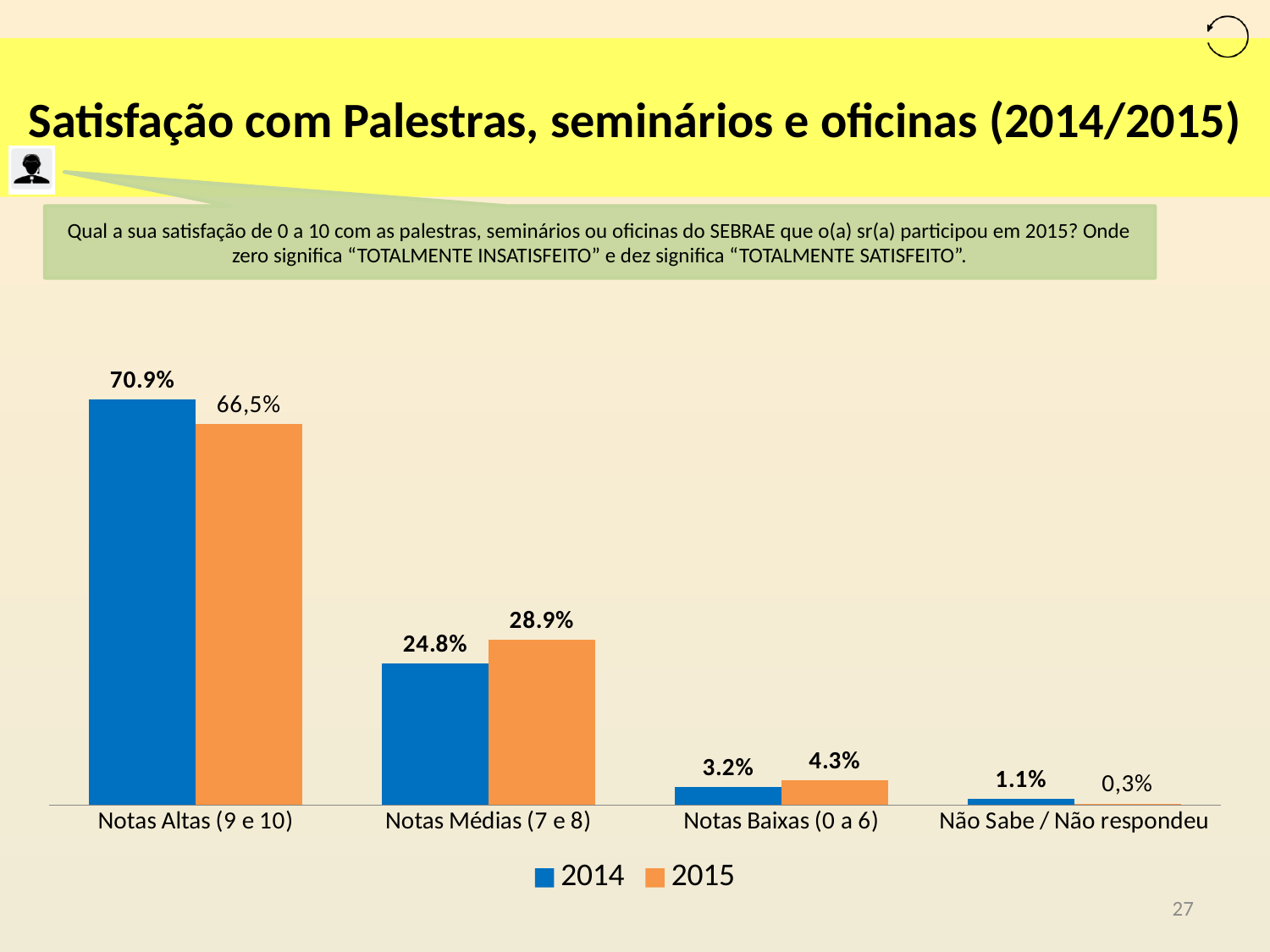
What kind of chart is shown on the slide? Bar chart What is the value for 2014 in the Notas Altas (9 e 10) category? 70.9% What is the difference between the 2015 and 2014 values in the Notas Baixas (0 a 6) category? 1.1% What is the difference between the 2015 and 2014 values in the Notas Médias (7 e 8) category? 4.1% How many categories are shown on the x axis of the chart? 4 How many series does the legend list? 2 Which category has the highest value for the 2015 series? Notas Altas (9 e 10) What is the value for 2015 in the Notas Médias (7 e 8) category? 28.9% In the Notas Altas (9 e 10) category, which series has the larger value, 2014 or 2015? 2014 Which category has the lowest value for the 2014 series? Não Sabe / Não respondeu What is the value for 2015 in the Notas Altas (9 e 10) category? 66,5% What is the value for 2014 in the Não Sabe / Não respondeu category? 1.1%